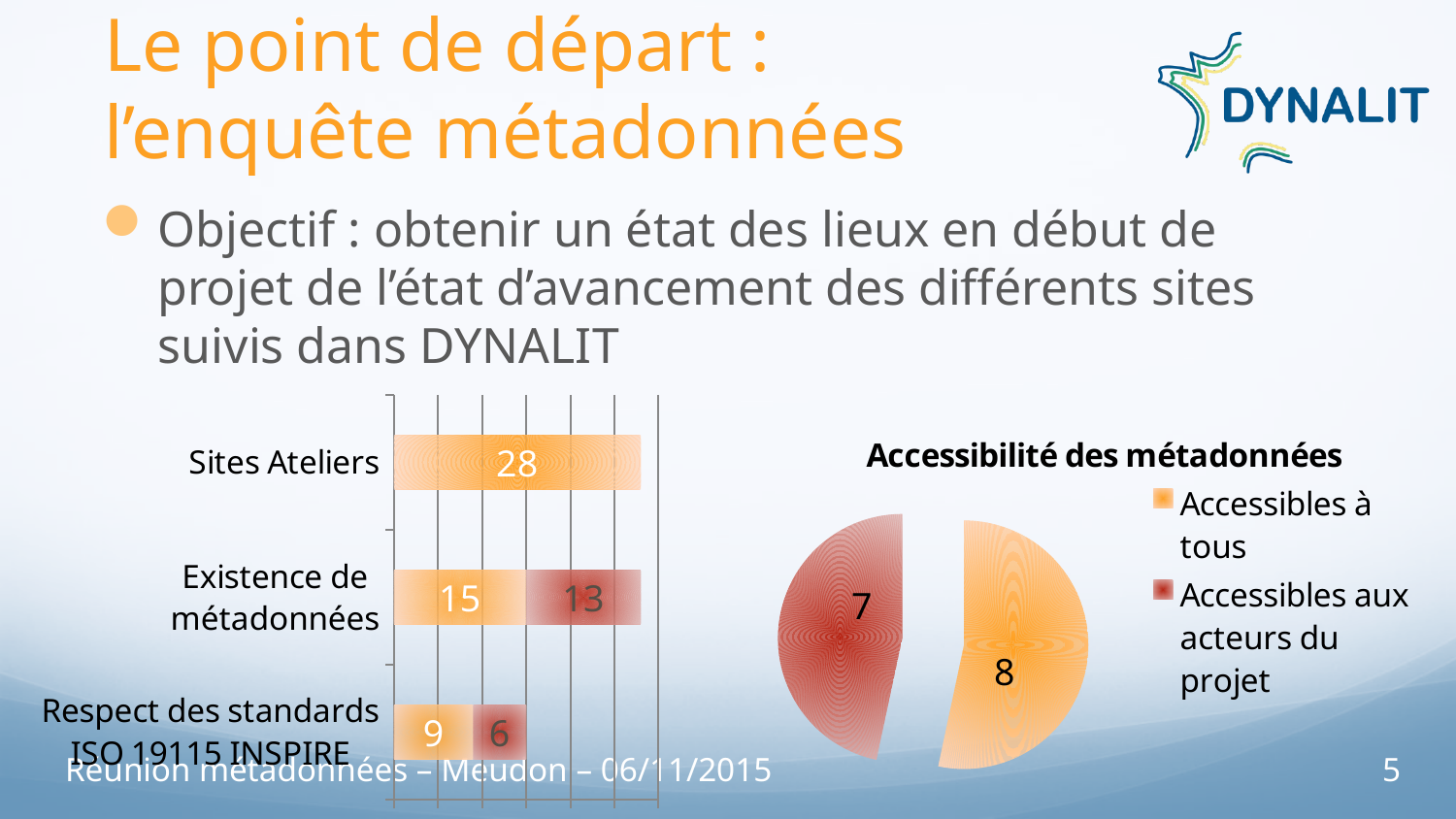
In the bar chart on the left, what is the value shown for Sites Ateliers? 28 In the bar chart on the left, what is the value of the orange segment for Existence de métadonnées? 15 In the bar chart on the left, what is the difference between the orange and red segments for Existence de métadonnées? 2 In the bar chart on the left, what is the total of the stacked bar for Respect des standards ISO 19115 INSPIRE? 15 In the bar chart on the left, how many categories are shown? 3 What type of chart is the chart on the left of the slide? Bar chart In the bar chart on the left, what is the total of the stacked bar for Existence de métadonnées? 28 How many entries does the legend of the pie chart 'Accessibilité des métadonnées' list? 2 In the bar chart on the left, what is the value of the red segment for Respect des standards ISO 19115 INSPIRE? 6 In the pie chart 'Accessibilité des métadonnées', which is larger: Accessibles à tous or Accessibles aux acteurs du projet? Accessibles à tous In the pie chart 'Accessibilité des métadonnées', what is the value for Accessibles à tous? 8 In the bar chart on the left, which category has the lowest total? Respect des standards ISO 19115 INSPIRE